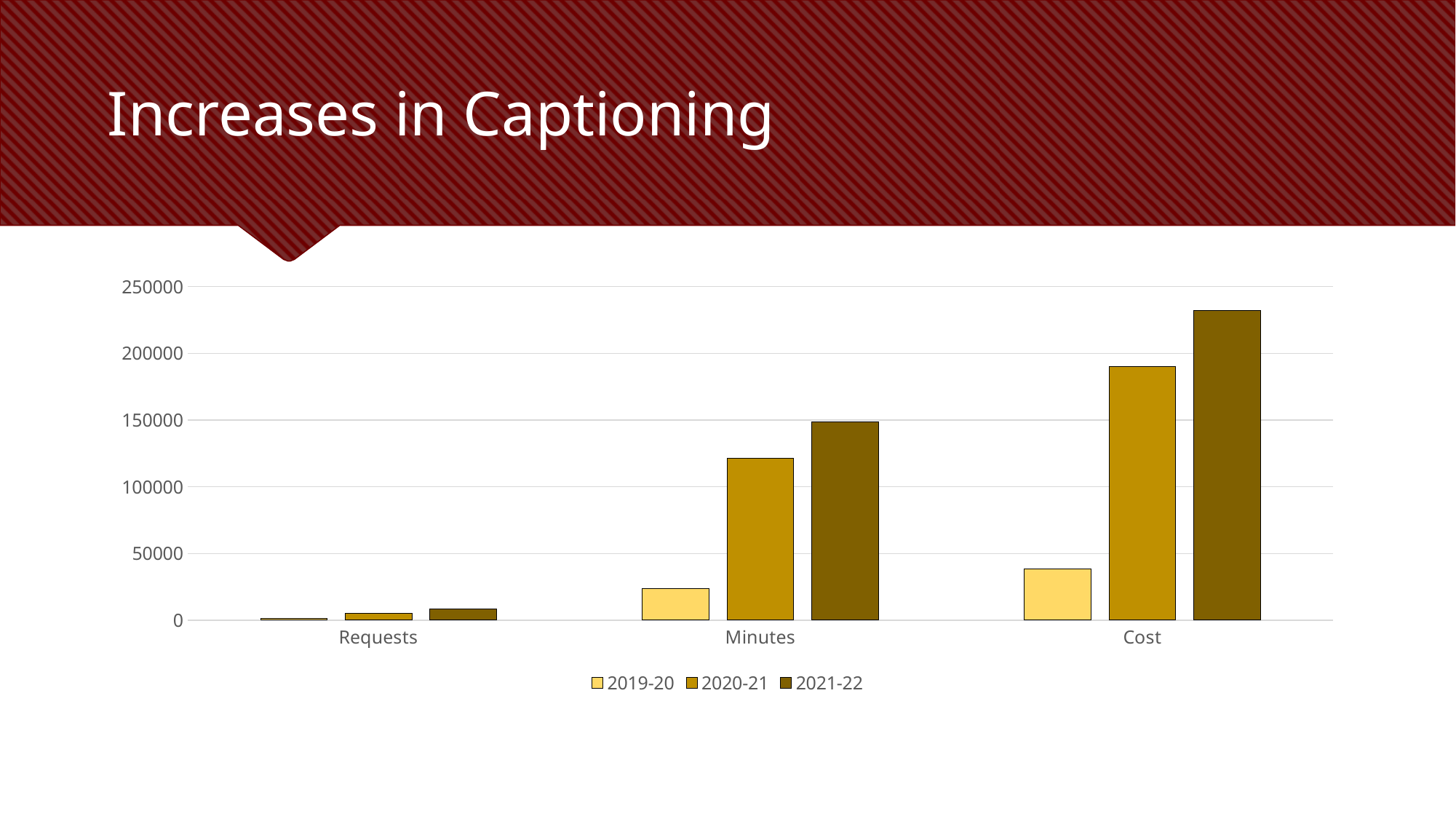
Within each category, do the values rise or fall from 2019-20 to 2021-22? rise Which category has the tallest bar overall? Cost Is the value for Cost in 2021-22 greater or less than 200000? greater How many categories are shown on the x axis? 3 Is the value for Cost in 2020-21 greater or less than 200000? less Is the value for Minutes in 2020-21 greater or less than 100000? greater What is the title of the slide? Increases in Captioning Which series are listed in the legend? 2019-20, 2020-21, 2021-22 How many series does the legend list? 3 Which category has the lowest values across all three years? Requests Which is larger, the 2021-22 value for Minutes or the 2021-22 value for Cost? Cost What kind of chart is shown on the slide? bar chart